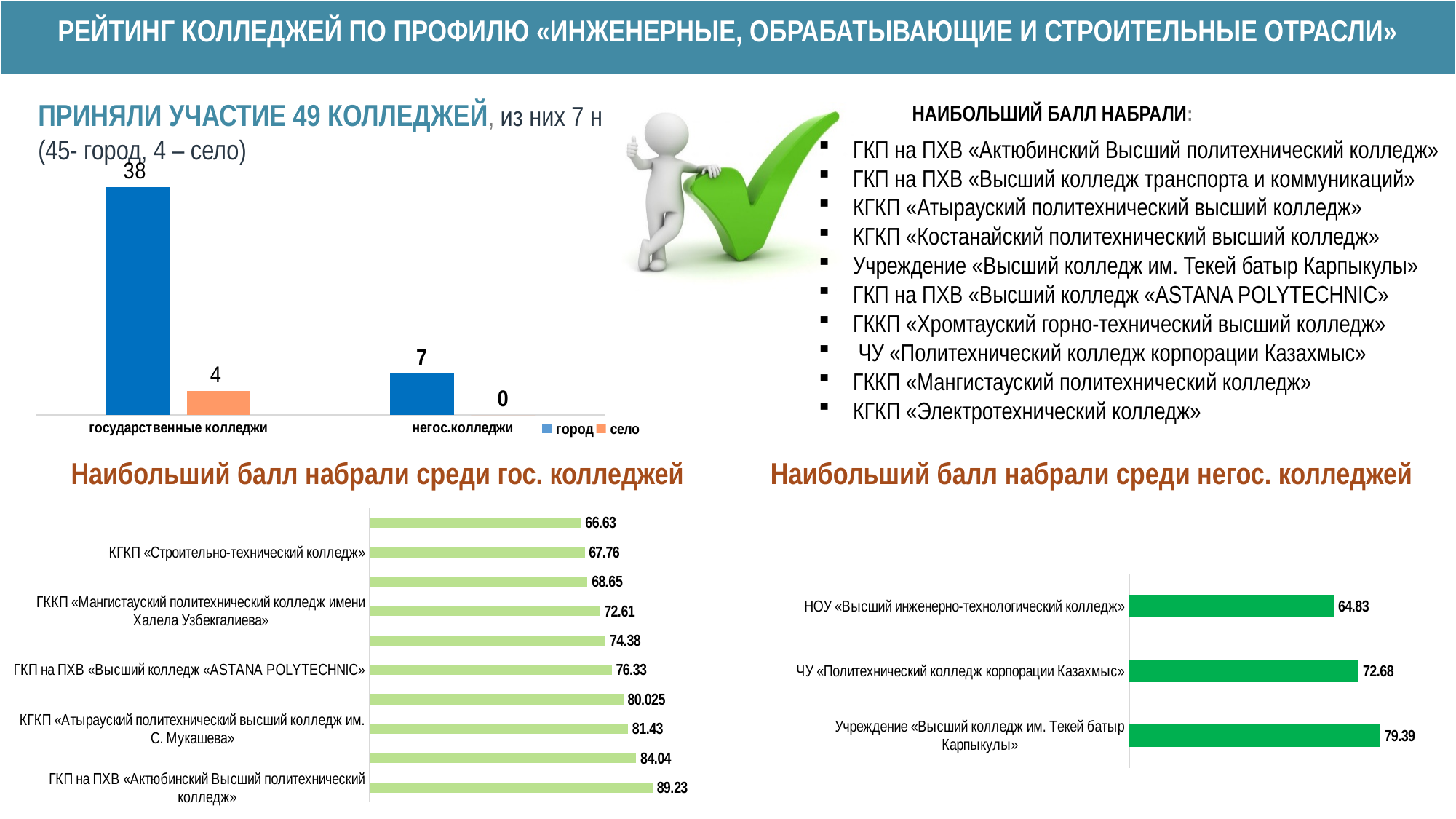
In the chart titled «Наибольший балл набрали среди гос. колледжей», what is the value for ГКП на ПХВ «Актюбинский Высший политехнический колледж»? 89.23 In the chart titled «Наибольший балл набрали среди негос. колледжей», which college has the lowest value? НОУ «Высший инженерно-технологический колледж» In the chart titled «Наибольший балл набрали среди гос. колледжей», what is the value for ГКП на ПХВ «Высший колледж «ASTANA POLYTECHNIC»? 76.33 What kind of chart is the one titled «Наибольший балл набрали среди гос. колледжей»? bar chart In the top-left bar chart, what is the value for город among государственные колледжи? 38 In the chart titled «Наибольший балл набрали среди негос. колледжей», how many colleges are shown? 3 In the top-left bar chart, what is the value for село among негос.колледжи? 0 In the top-left bar chart, what is the total of город and село for негос.колледжи? 7 In the chart titled «Наибольший балл набрали среди негос. колледжей», what is the difference between ЧУ «Политехнический колледж корпорации Казахмыс» and НОУ «Высший инженерно-технологический колледж»? 7.85 In the top-left bar chart, what is the difference between город and село for государственные колледжи? 34 In the top-left bar chart, how many series does the legend list? 2 In the chart titled «Наибольший балл набрали среди негос. колледжей», what is the value for Учреждение «Высший колледж им. Текей батыр Карпыкулы»? 79.39